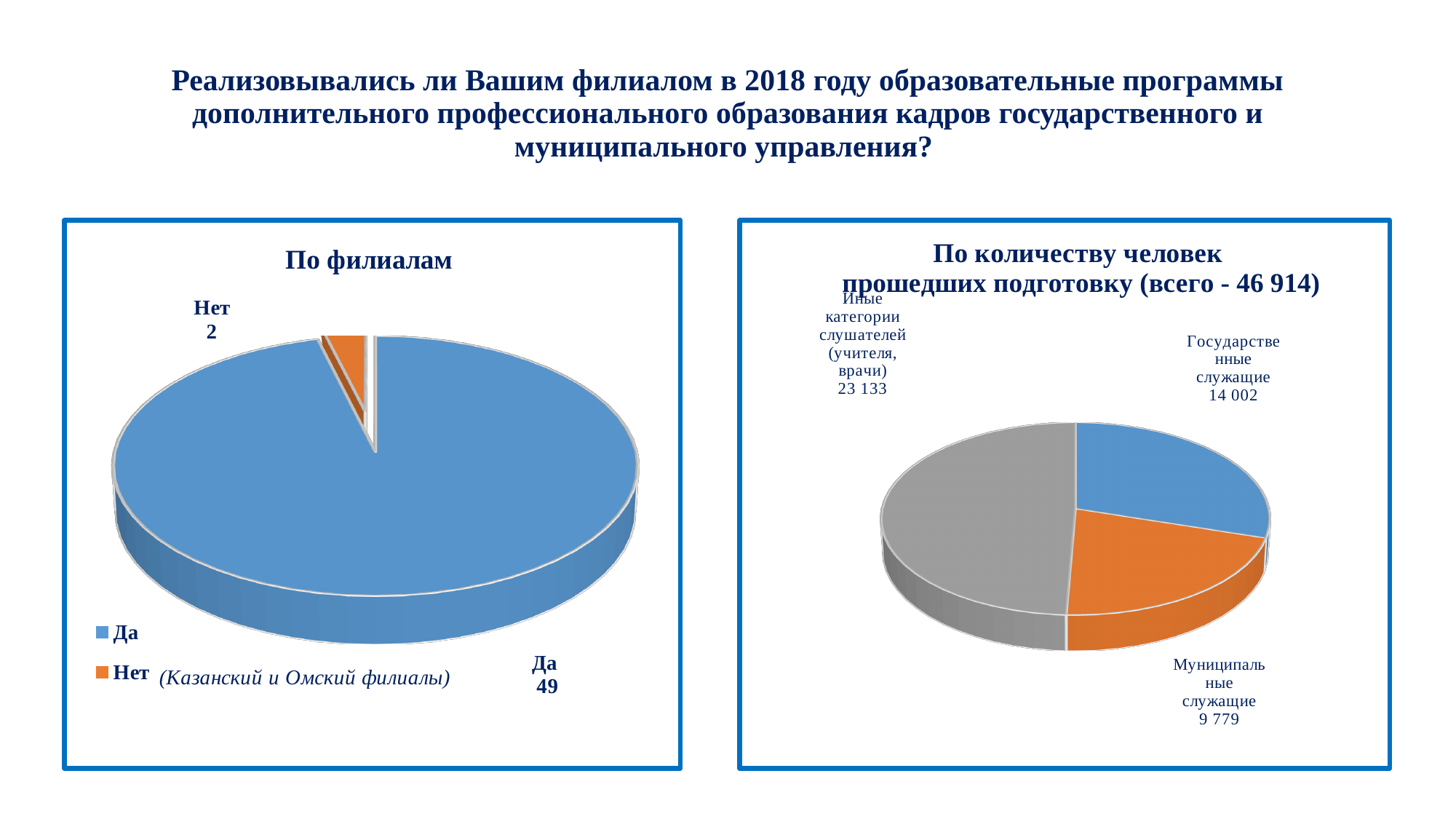
In the "По филиалам" chart, what is the difference between the values for "Да" and "Нет"? 47 In the "По филиалам" chart, how many categories are shown? 2 In the "По количеству человек прошедших подготовку" chart, what is the value for "Государственные служащие"? 14 002 In the "По филиалам" chart, what is the value for "Да"? 49 In the "По количеству человек прошедших подготовку" chart, what is the value for "Муниципальные служащие"? 9 779 What type of chart is the "По филиалам" chart? pie chart In the "По количеству человек прошедших подготовку" chart, which category has the highest value? Иные категории слушателей (учителя, врачи) In the "По количеству человек прошедших подготовку" chart, which category has the lowest value? Муниципальные служащие In the "По количеству человек прошедших подготовку" chart, what is the difference between "Иные категории слушателей (учителя, врачи)" and "Государственные служащие"? 9 131 What total number of people is stated in the title of the right-hand chart? 46 914 In the "По филиалам" chart, what is the value for "Нет"? 2 In the "По филиалам" chart, which branches are named as answering "Нет"? Казанский и Омский филиалы